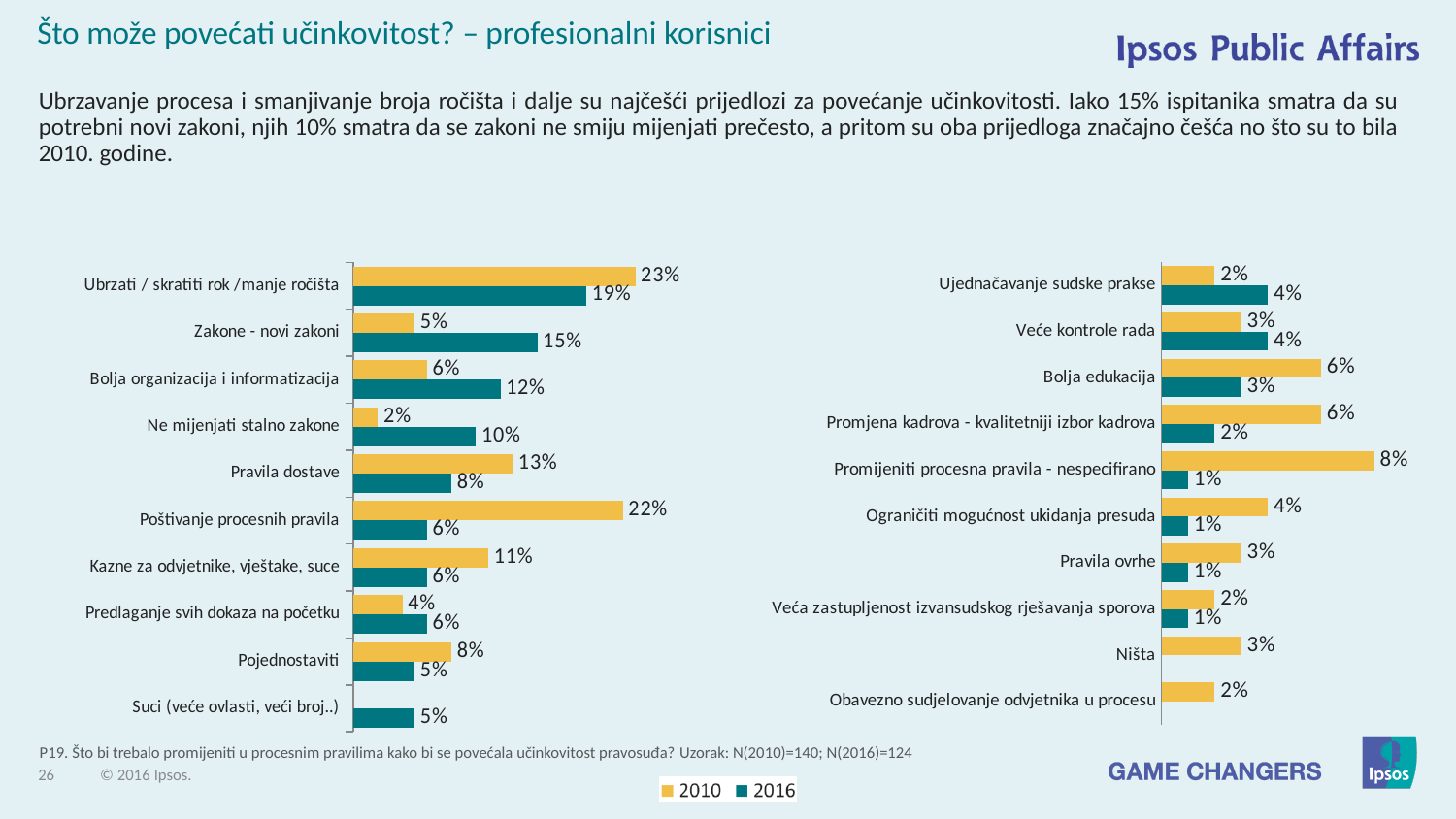
In the left chart, what is the 2010 value for 'Poštivanje procesnih pravila'? 22% In the left chart, which category has the lowest 2010 value among those with a 2010 bar? Ne mijenjati stalno zakone How many categories are shown in the right chart? 10 In the right chart, which category has the highest 2010 value? Promijeniti procesna pravila - nespecifirano In the right chart, what is the difference between the 2010 and 2016 values for 'Bolja edukacija'? 3% In the left chart, which is larger for 'Pravila dostave': the 2010 value or the 2016 value? 2010 In the right chart, what is the 2010 value for 'Promijeniti procesna pravila - nespecifirano'? 8% What type of chart is used on the left side of the slide? Bar chart In the left chart, what is the 2016 value for 'Zakone - novi zakoni'? 15% In the left chart, what is the difference between the 2010 and 2016 values for 'Ne mijenjati stalno zakone'? 8% In the left chart, which category has the highest 2016 value? Ubrzati / skratiti rok /manje ročišta How many series does the legend list? 2